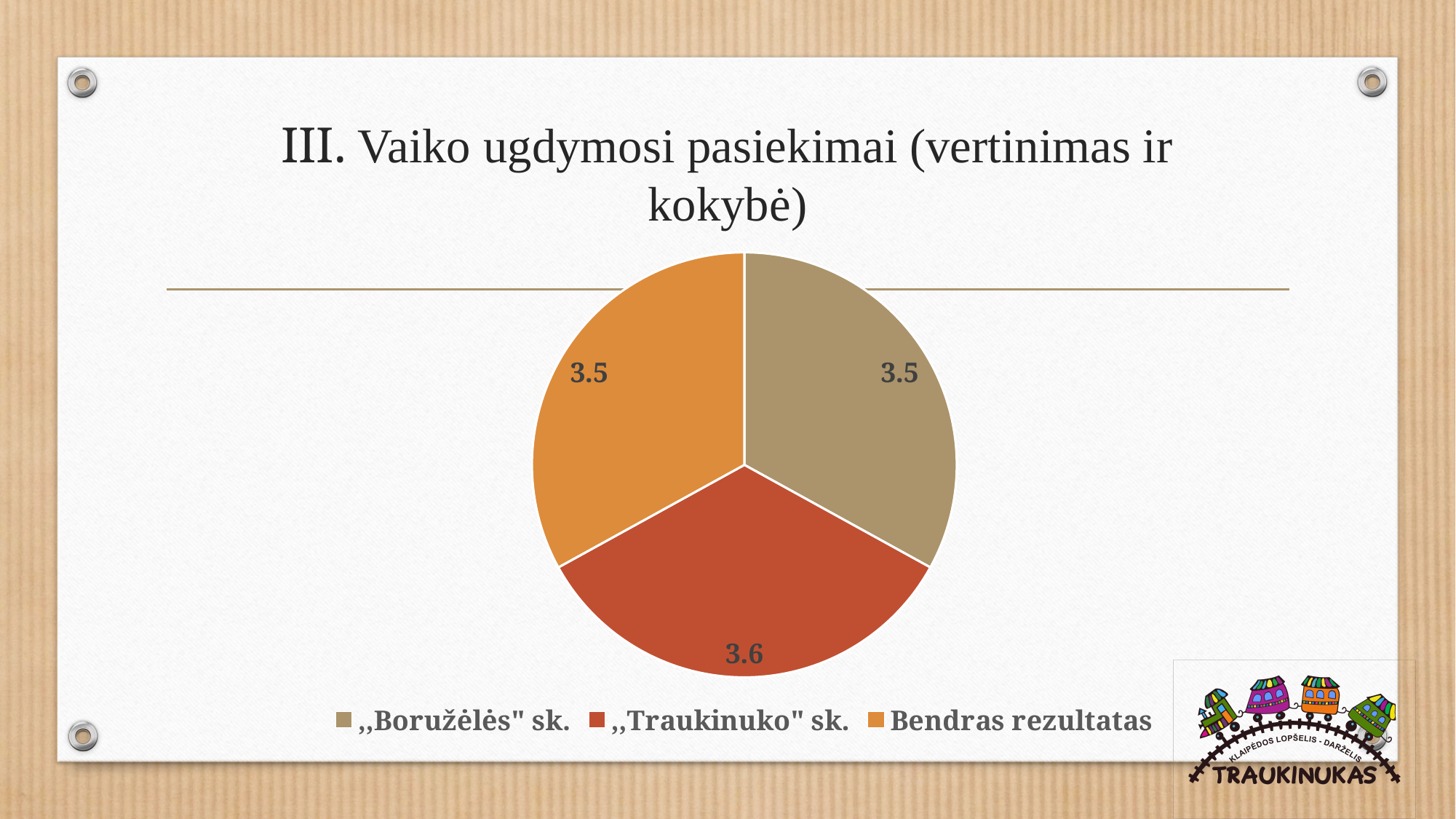
What value is shown for ,,Traukinuko" sk. in the pie chart? 3.6 How many slices does the pie chart have? 3 Which legend entry is shown in orange? Bendras rezultatas What is the sum of all three values shown in the pie chart? 10.6 What kind of chart is shown on the slide? Pie chart What value is shown for Bendras rezultatas in the pie chart? 3.5 Which category has the highest value in the pie chart? ,,Traukinuko" sk. Which is larger: the value for ,,Traukinuko" sk. or the value for Bendras rezultatas? ,,Traukinuko" sk. What value is shown for ,,Boružėlės" sk. in the pie chart? 3.5 What is the difference between the values for ,,Traukinuko" sk. and ,,Boružėlės" sk.? 0.1 What is the title of the chart on the slide? III. Vaiko ugdymosi pasiekimai (vertinimas ir kokybė) How many entries does the legend list? 3